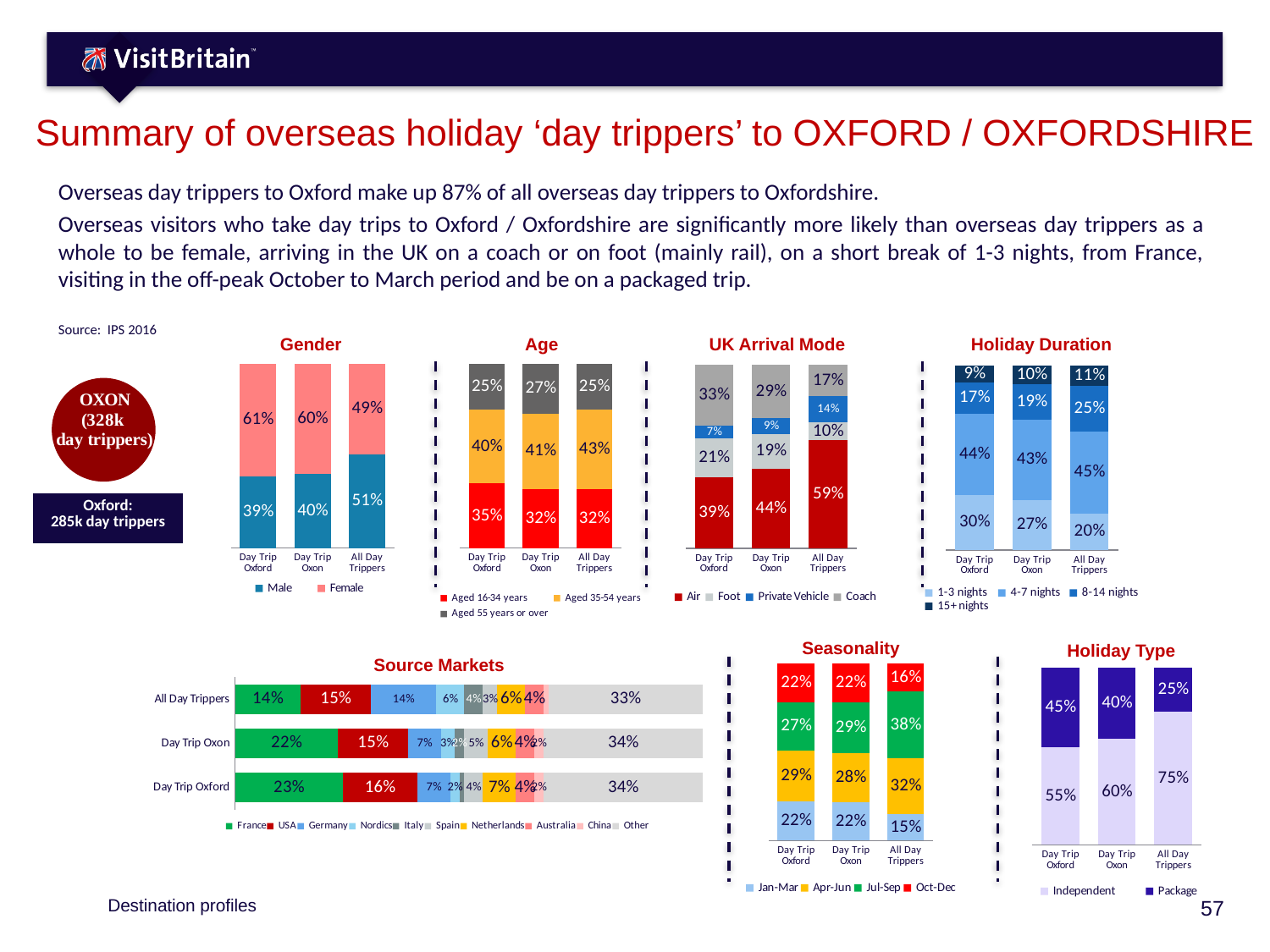
In the Source Markets chart, is the USA share larger for Day Trip Oxford or for All Day Trippers? Day Trip Oxford In the Gender chart, what percentage of Day Trip Oxford visitors are female? 61% In the Seasonality chart, what is the Jul-Sep share for All Day Trippers? 38% In the UK Arrival Mode chart, how many arrival modes does the legend list? 4 In the Holiday Duration chart, which group has the lowest share of 1-3 nights stays? All Day Trippers In the Gender chart, which group has the highest male share? All Day Trippers In the Holiday Type chart, what is the Package share for Day Trip Oxon? 40% What type of chart is the Source Markets chart? Stacked bar chart In the Holiday Duration chart, what percentage of Day Trip Oxford visitors stay 1-3 nights? 30% In the Source Markets chart, what is the France share for Day Trip Oxford? 23% In the UK Arrival Mode chart, what is the difference between the Air share for All Day Trippers and for Day Trip Oxford? 20 percentage points In the Age chart, what percentage of Day Trip Oxon visitors are aged 35-54 years? 41%